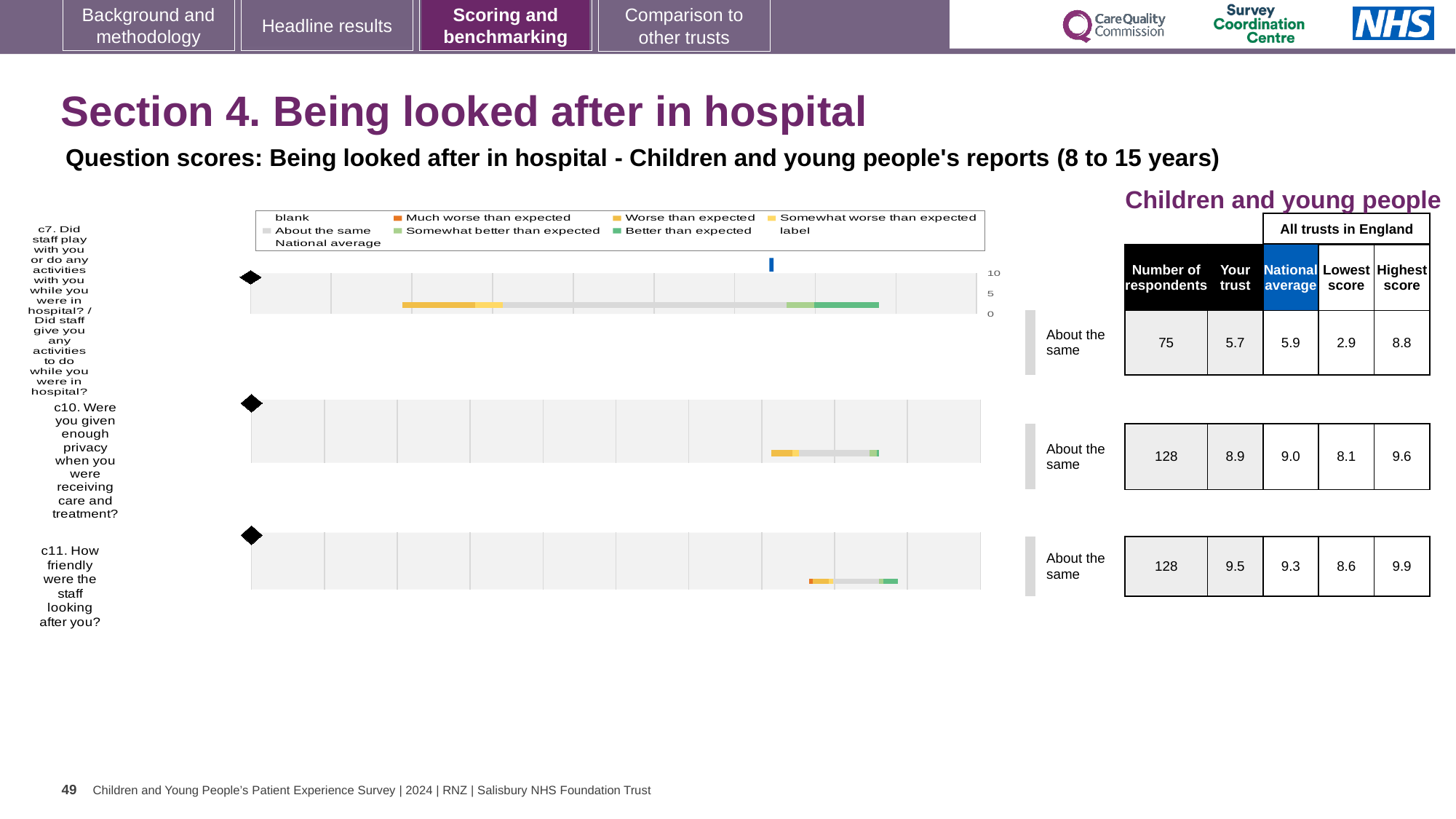
How many survey questions are plotted on this slide? 3 How many respondents answered question c7 (Did staff play with you or do any activities with you while you were in hospital?)? 75 What kind of chart is used to show the question scores on this slide? bar chart For question c10, which is larger: the 'Your trust' score or the national average? National average Is the 'Your trust' score for question c7 greater or less than 5? greater What benchmark category is shown for question c7? About the same For question c7, how much higher is the national average than the 'Your trust' score? 0.2 What is the 'Your trust' score for question c10 (Were you given enough privacy when you were receiving care and treatment?)? 8.9 Which question has the lowest 'Your trust' score? c7. Did staff play with you or do any activities with you while you were in hospital? What is the national average score for question c11 (How friendly were the staff looking after you?)? 9.3 For question c11, what is the difference between the highest score and the lowest score across all trusts in England? 1.3 Which question has the highest 'Your trust' score? c11. How friendly were the staff looking after you?